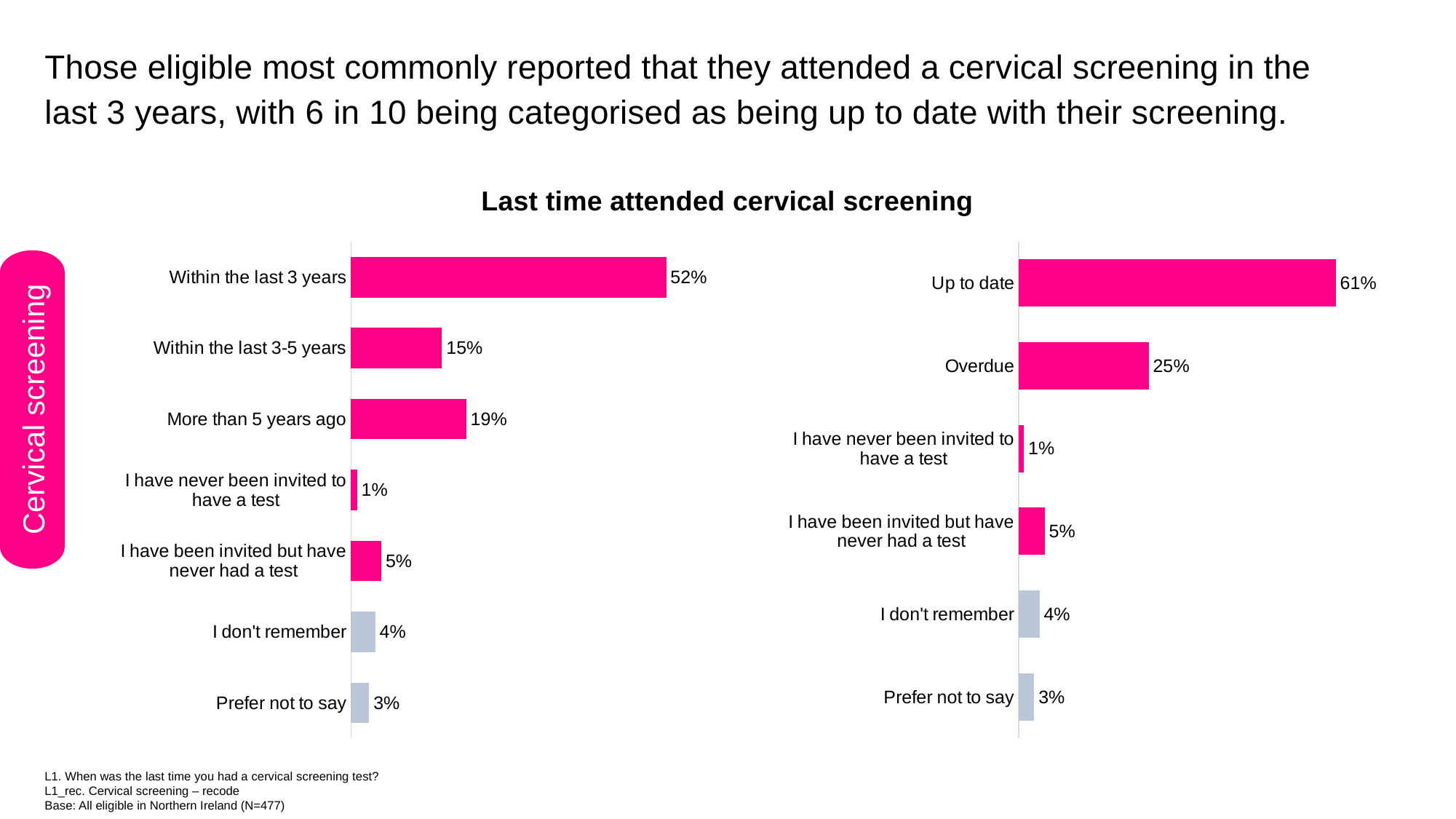
In the right chart, what percentage are categorised as up to date? 61% In the left chart, what is the value for 'More than 5 years ago'? 19% In the left chart, what percentage reported attending a cervical screening within the last 3 years? 52% In the right chart, what is the difference between 'Up to date' and 'Overdue'? 36% In the left chart, which is larger: 'Within the last 3-5 years' or 'More than 5 years ago'? More than 5 years ago How many categories does the left chart show? 7 In the right chart, which category has the lowest value? I have never been invited to have a test In the right chart, what is the value for 'Overdue'? 25% In the left chart, which category has the highest value? Within the last 3 years In the left chart, what is the difference between 'More than 5 years ago' and 'Within the last 3-5 years'? 4% What type of chart is used on the slide? Bar chart How many categories does the right chart show? 6